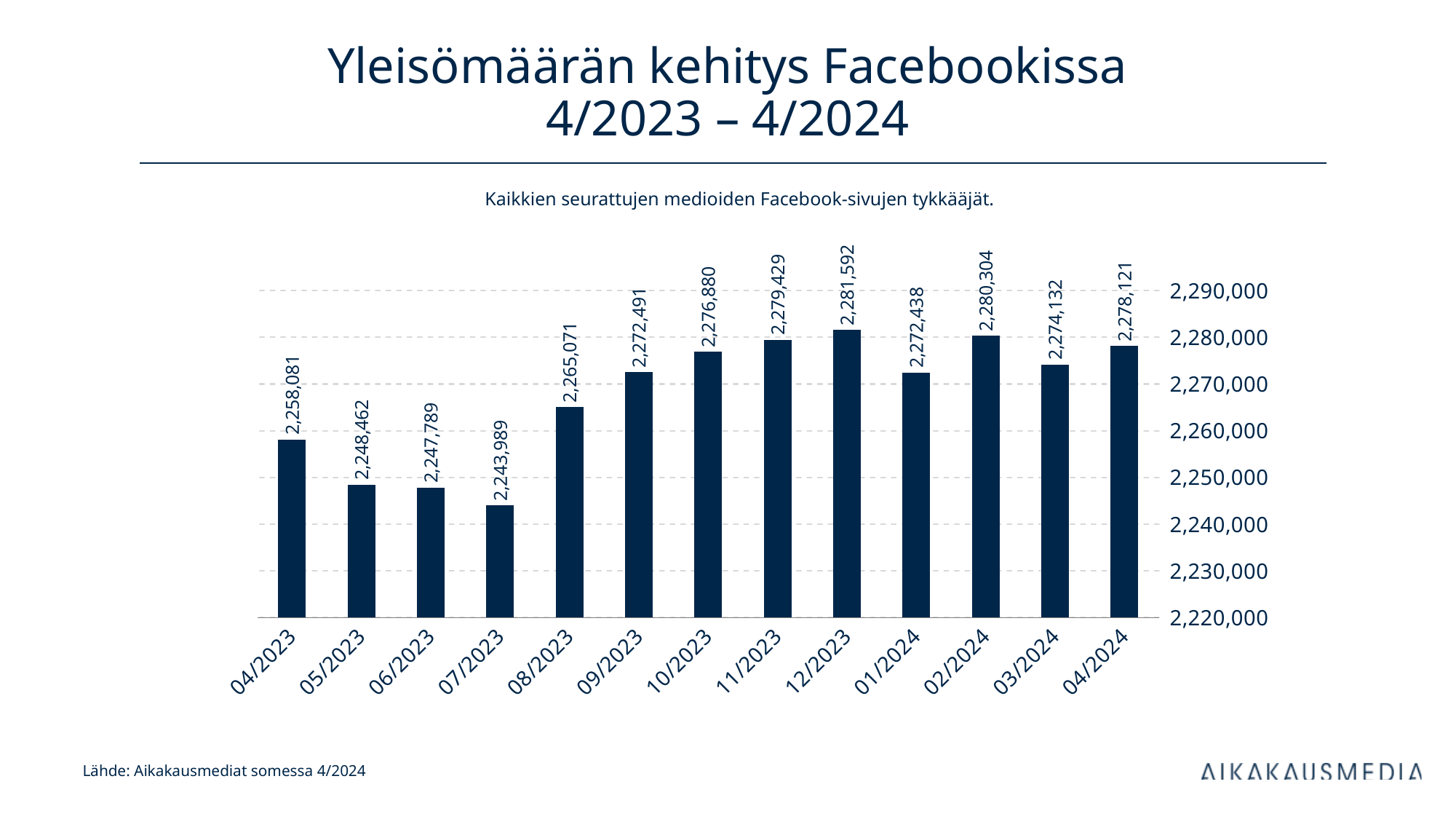
What is the value for 04/2023? 2,258,081 How many months are shown on the x axis? 13 What is the value for 12/2023? 2,281,592 Which month has the lowest value? 07/2023 What kind of chart is shown on the slide? bar chart Which month has the highest value? 12/2023 Is the value for 07/2023 greater or less than 2,250,000? less What is the value for 04/2024? 2,278,121 What is the difference between the values for 04/2024 and 04/2023? 20,040 Which is larger, the value for 02/2024 or the value for 03/2024? 02/2024 What is the value for 08/2023? 2,265,071 What is the difference between the highest value (12/2023) and the lowest value (07/2023)? 37,603